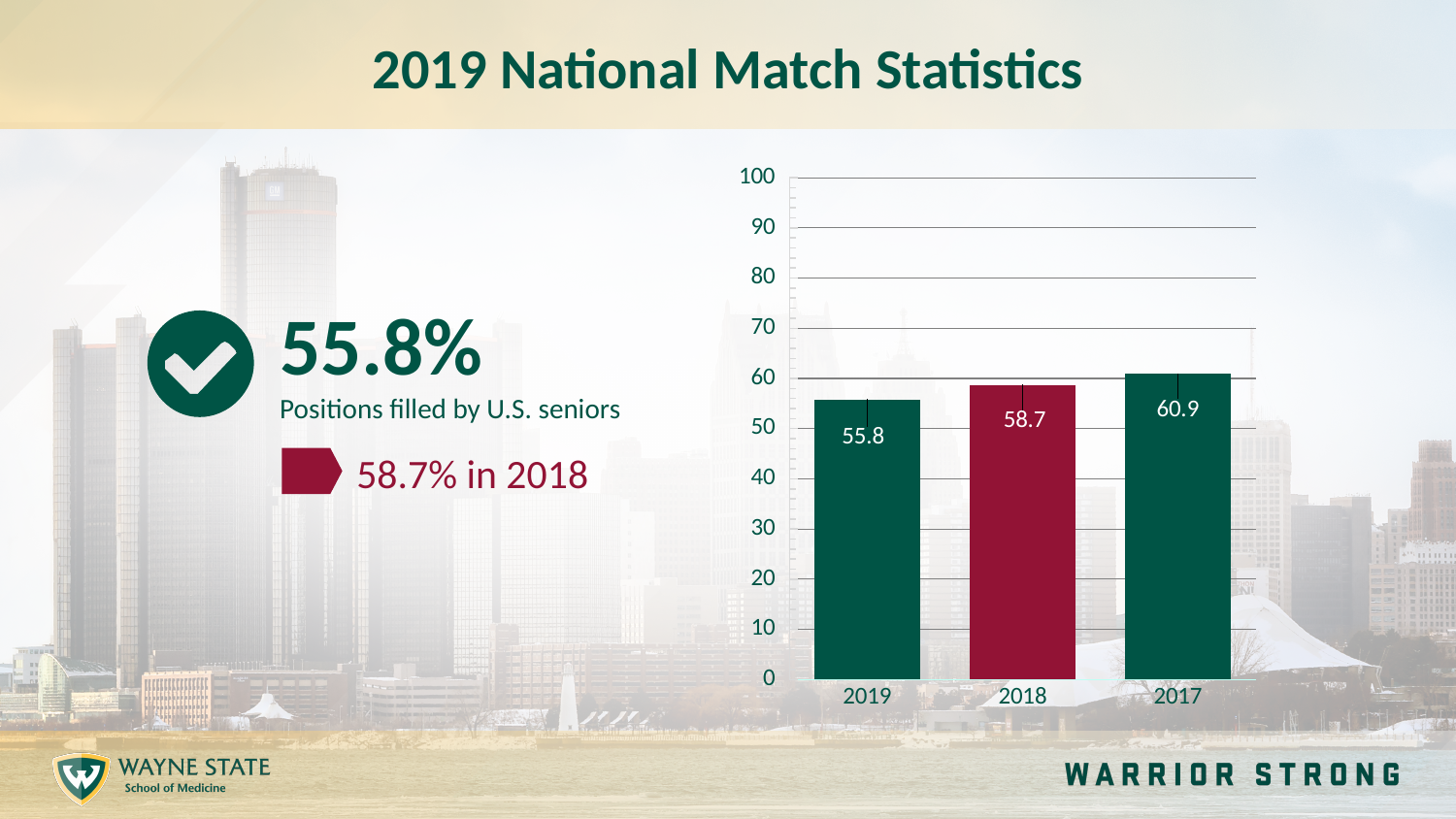
What kind of chart is shown on the slide? Bar chart What is the value for 2018 in the bar chart? 58.7 What is the difference between the values for 2018 and 2019 in the bar chart? 2.9 Which bar in the chart is coloured maroon rather than green? 2018 How many bars are shown in the bar chart? 3 What is the difference between the values for 2017 and 2019 in the bar chart? 5.1 Which year has the lowest value in the bar chart? 2019 What is the value for 2019 in the bar chart? 55.8 Is the value for 2017 in the bar chart greater or less than 60? greater What is the value for 2017 in the bar chart? 60.9 Which year has the highest value in the bar chart? 2017 Which is larger in the bar chart, the value for 2018 or the value for 2019? 2018